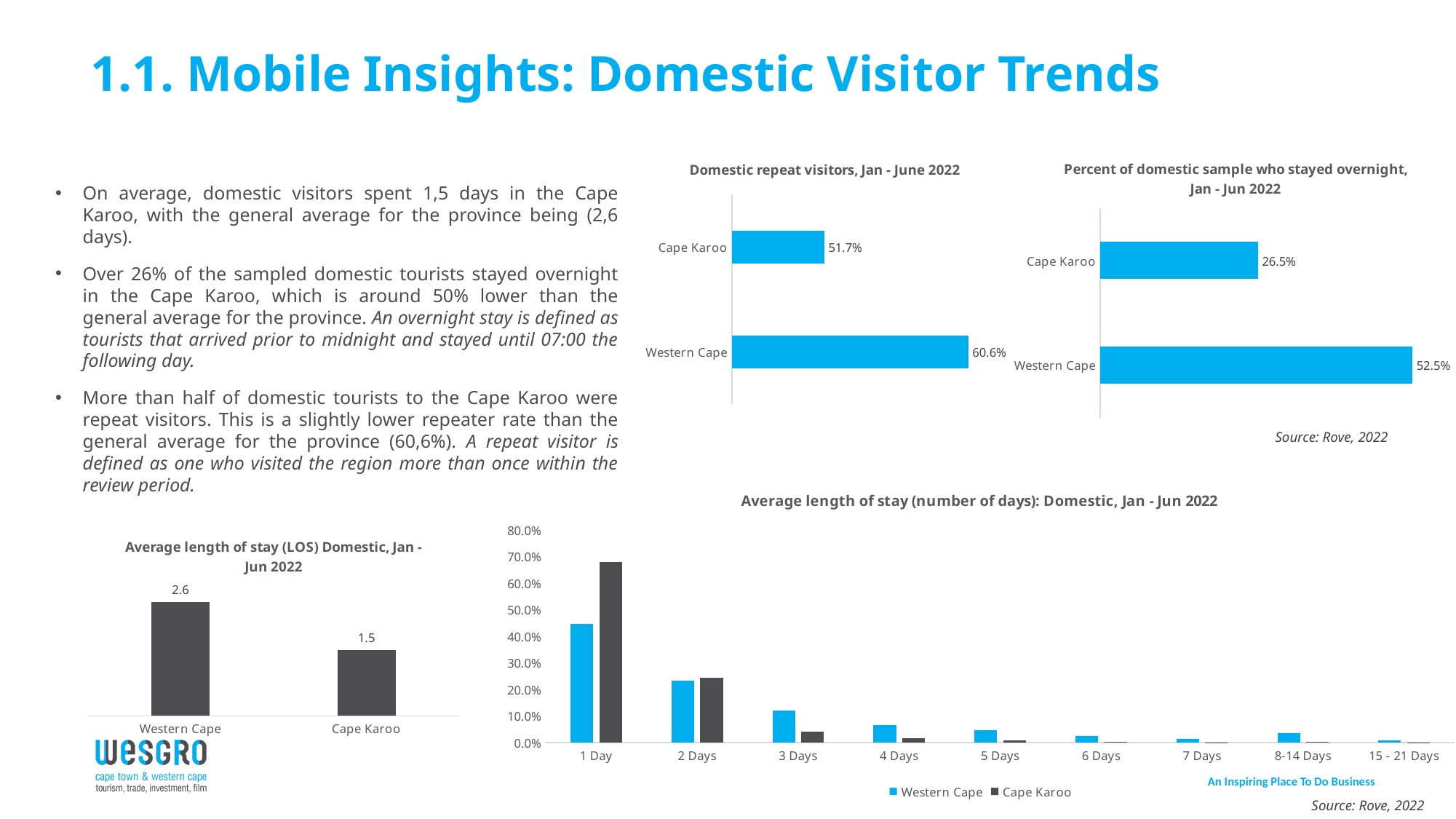
In the 'Percent of domestic sample who stayed overnight, Jan - Jun 2022' chart, what is the value for Cape Karoo? 26.5% In the 'Average length of stay (number of days): Domestic, Jan - Jun 2022' chart, how many categories are shown on the x axis? 9 In the 'Average length of stay (number of days): Domestic, Jan - Jun 2022' chart, which series has the larger value for 3 Days, Western Cape or Cape Karoo? Western Cape In the 'Domestic repeat visitors, Jan - June 2022' chart, what is the difference between the Western Cape and Cape Karoo values? 8.9% In the 'Percent of domestic sample who stayed overnight, Jan - Jun 2022' chart, which category has the higher value? Western Cape In the 'Domestic repeat visitors, Jan - June 2022' chart, what is the value for Western Cape? 60.6% In the 'Average length of stay (number of days): Domestic, Jan - Jun 2022' chart, is the Cape Karoo value for 1 Day greater or less than 60.0%? greater In the 'Percent of domestic sample who stayed overnight, Jan - Jun 2022' chart, what is the difference between Western Cape and Cape Karoo? 26.0% In the 'Domestic repeat visitors, Jan - June 2022' chart, what is the value for Cape Karoo? 51.7% In the 'Average length of stay (LOS) Domestic, Jan - Jun 2022' chart, which category has the lowest value? Cape Karoo In the 'Average length of stay (number of days): Domestic, Jan - Jun 2022' chart, how many series does the legend list? 2 In the 'Average length of stay (LOS) Domestic, Jan - Jun 2022' chart, what is the value for Cape Karoo? 1.5